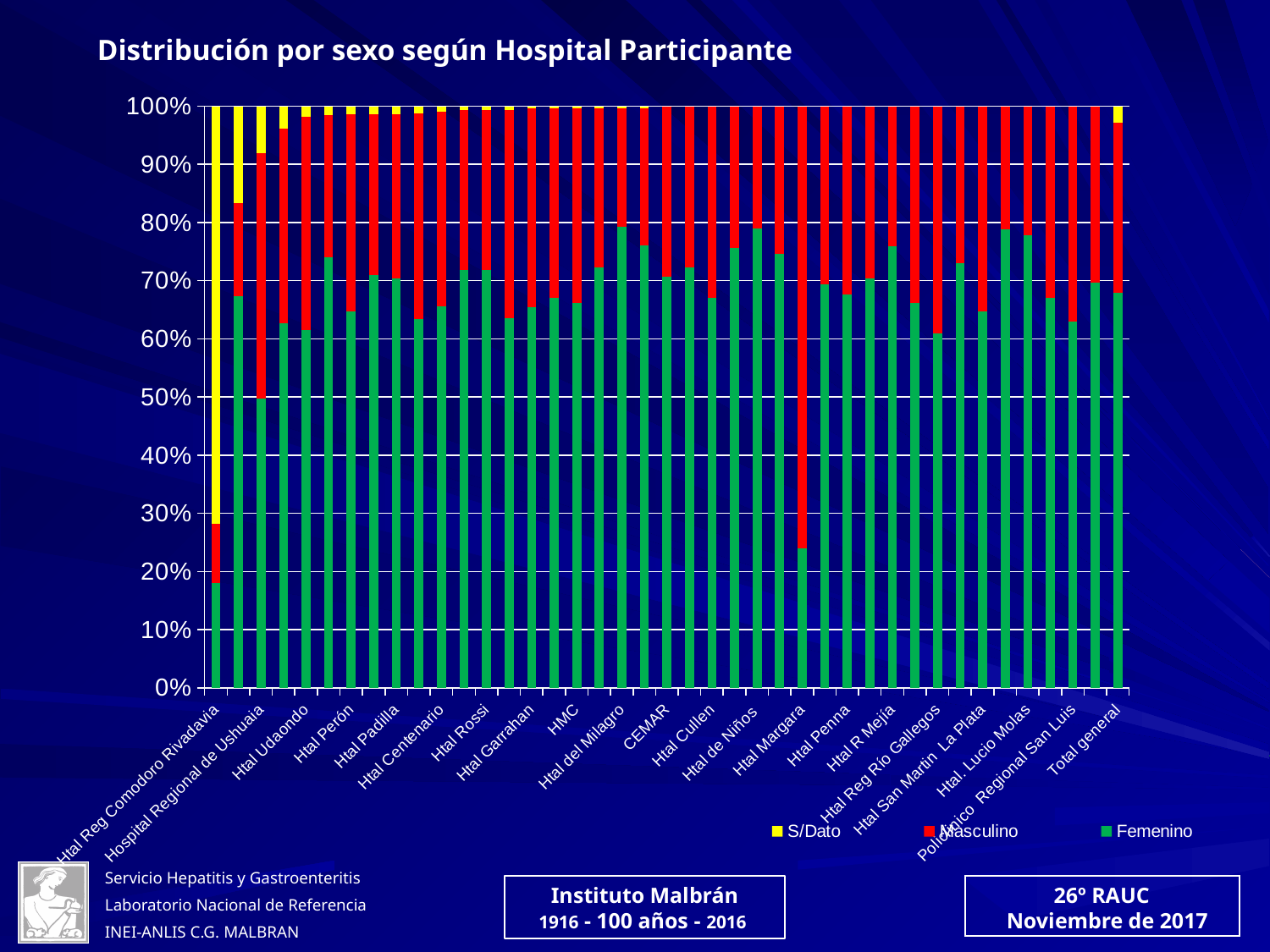
What is the title of the chart? Distribución por sexo según Hospital Participante Is the S/Dato share for Htal Reg Comodoro Rivadavia greater or less than 60%? greater What kind of chart is shown on the slide? Stacked bar chart Is the Femenino share for Htal Margara greater or less than 30%? less Which has the larger Femenino share, Htal Margara or Htal Penna? Htal Penna What are the three series listed in the legend? S/Dato, Masculino, Femenino Is the Femenino share for Total general greater or less than 60%? greater How many series does the legend list? 3 Which hospital has the largest S/Dato (yellow) share? Htal Reg Comodoro Rivadavia Which has the larger Femenino share, Htal Reg Comodoro Rivadavia or Hospital Regional de Ushuaia? Hospital Regional de Ushuaia